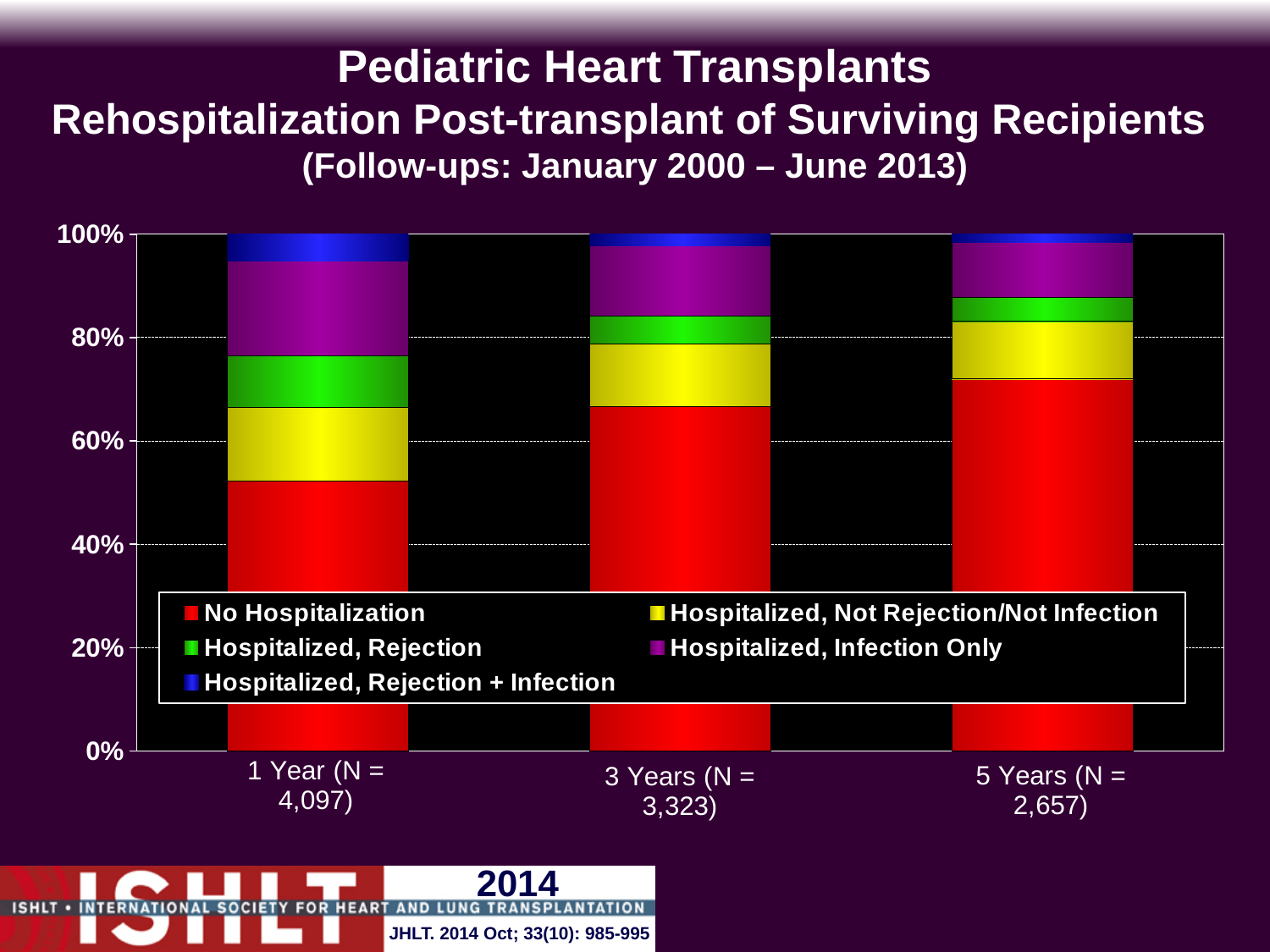
Is the No Hospitalization share at 5 Years greater or less than 60%? greater How many series does the legend list? 5 Does the No Hospitalization share rise or fall from 1 Year to 5 Years? rise Is the Hospitalized, Not Rejection/Not Infection share larger at 1 Year or at 5 Years? 1 Year Which colour represents Hospitalized, Infection Only in the legend? Purple Which category has the largest No Hospitalization share? 5 Years (N = 2,657) Is the No Hospitalization share at 1 Year greater or less than 60%? less What is the N shown for the 1 Year category? 4,097 How many time-point categories are shown on the x axis? 3 Is the No Hospitalization share at 1 Year greater or less than 40%? greater What is the N shown for the 3 Years category? 3,323 What kind of chart is shown on the slide? Stacked bar chart